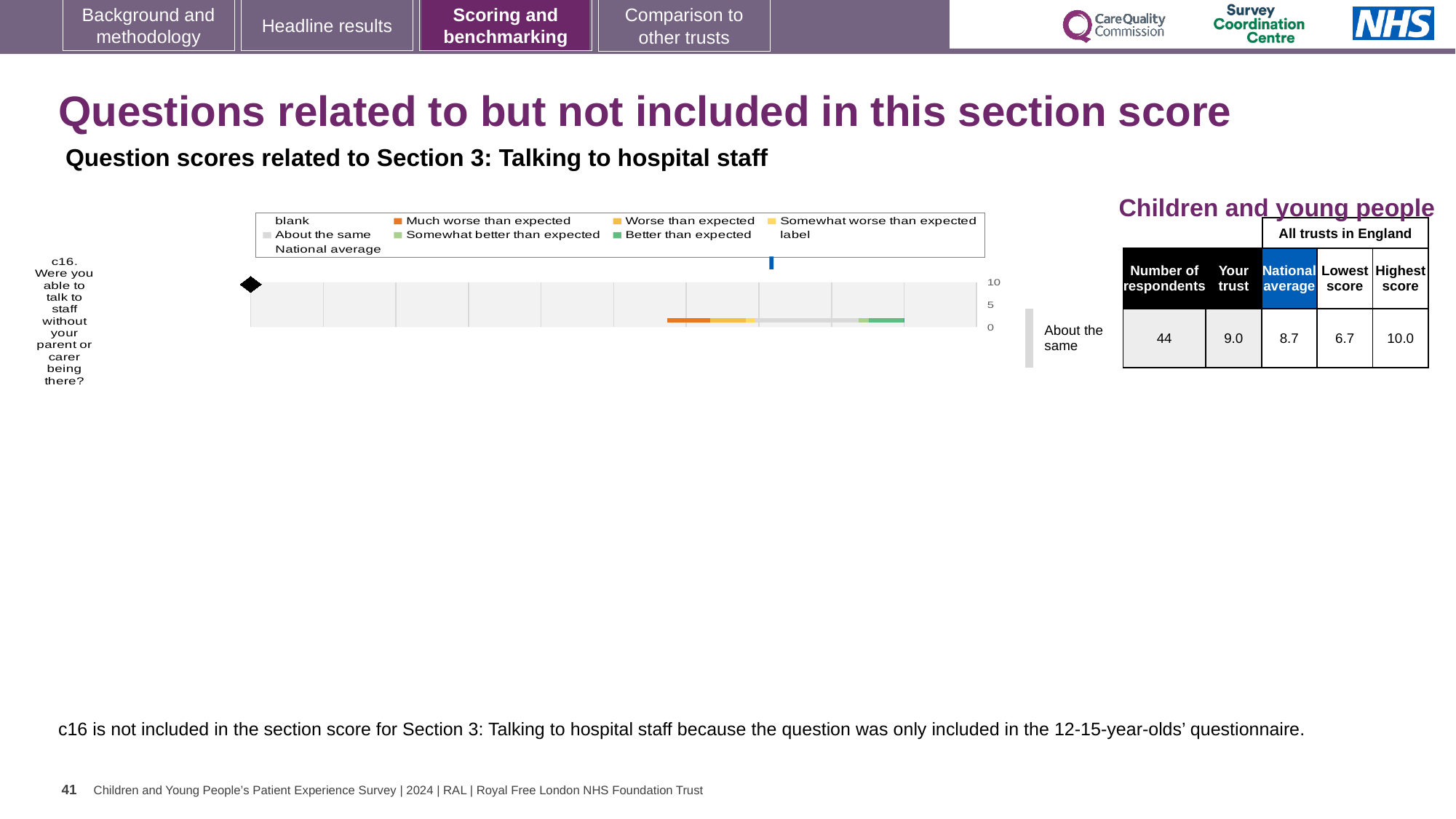
What is the difference between the 'Your trust' score and the national average for c16? 0.3 How many survey questions are plotted in the chart? 1 What is the highest value shown on the chart's score axis? 10 What is the highest score among all trusts in England for c16? 10.0 What is the benchmark category shown for c16 next to the chart? About the same How many respondents answered c16? 44 What kind of chart is used to show the c16 question score? bar chart What is the national average score for c16? 8.7 For c16, which is larger: the 'Your trust' score or the national average? Your trust Which question is plotted in the chart? c16. Were you able to talk to staff without your parent or carer being there? What is the lowest score among all trusts in England for c16? 6.7 What is the 'Your trust' score for c16? 9.0